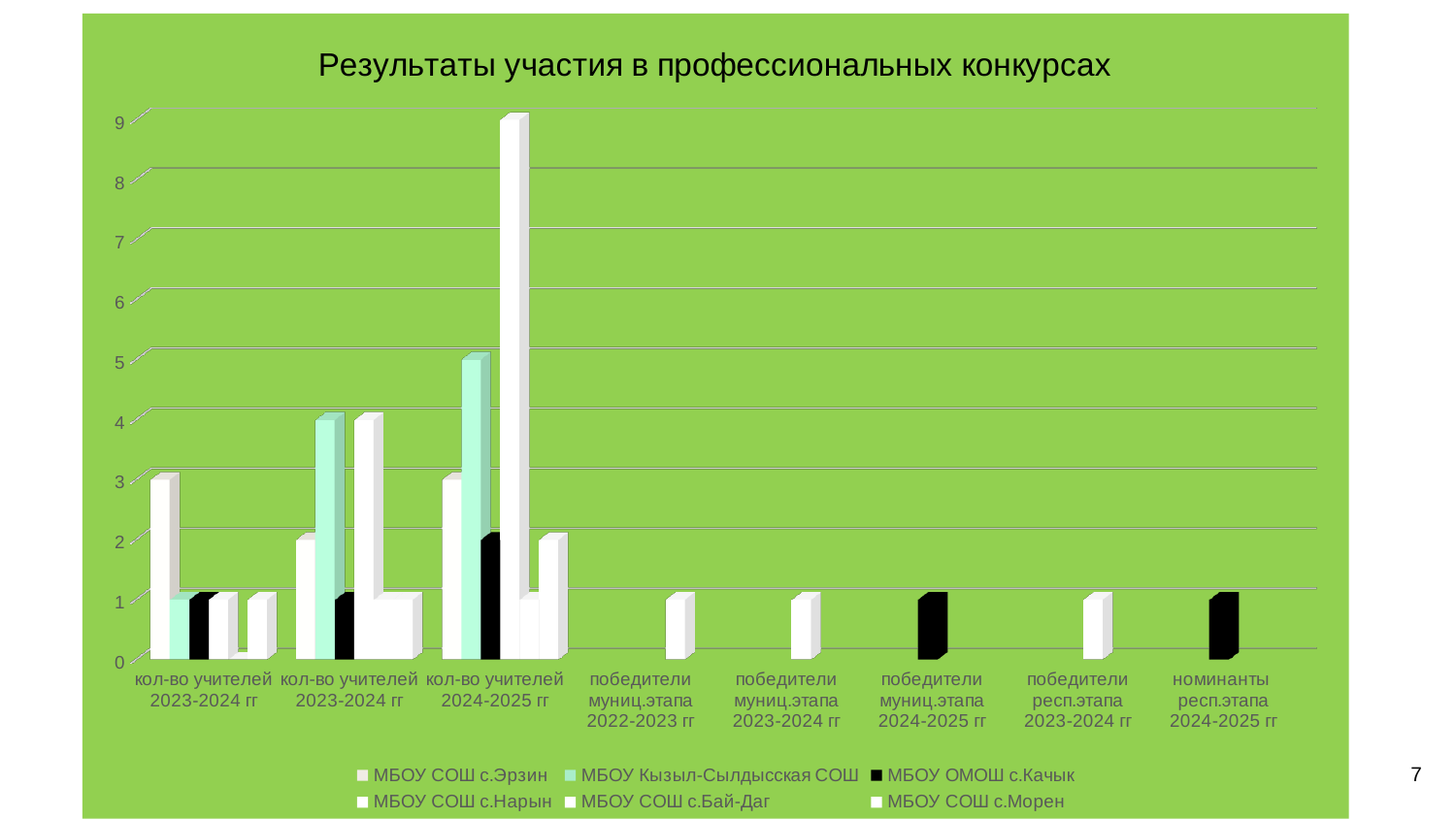
What is the value for МБОУ ОМОШ с.Качык in the category 'кол-во учителей 2024-2025 гг'? 2 What is the value for МБОУ Кызыл-Сылдысская СОШ in the category 'кол-во учителей 2024-2025 гг'? 5 What is the title of the chart? Результаты участия в профессиональных конкурсах How many series does the legend list? 6 In the category 'кол-во учителей 2024-2025 гг', which is larger: МБОУ Кызыл-Сылдысская СОШ or МБОУ СОШ с.Эрзин? МБОУ Кызыл-Сылдысская СОШ What is the value for МБОУ ОМОШ с.Качык in the category 'победители муниц.этапа 2024-2025 гг'? 1 What is the value for МБОУ СОШ с.Эрзин in the category 'кол-во учителей 2024-2025 гг'? 3 In the category 'кол-во учителей 2024-2025 гг', what is the difference between МБОУ Кызыл-Сылдысская СОШ and МБОУ СОШ с.Эрзин? 2 What kind of chart is shown on the slide? Bar chart Is the tallest bar in the category 'кол-во учителей 2024-2025 гг' greater or less than 8? greater How many categories are shown along the x axis? 8 Which category contains the tallest bar in the chart? кол-во учителей 2024-2025 гг